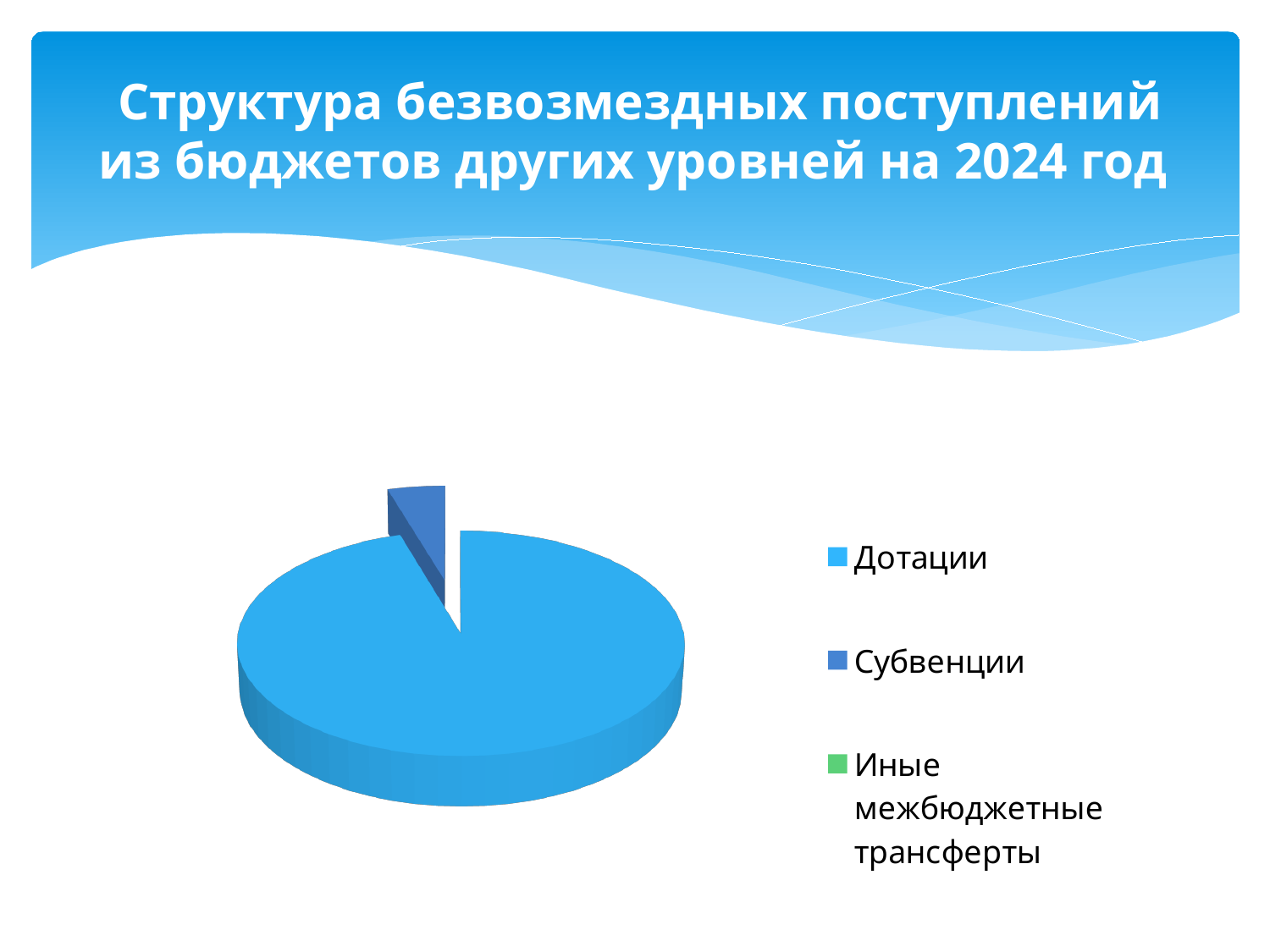
What is the title of the slide? Структура безвозмездных поступлений из бюджетов других уровней на 2024 год Which slice is larger, Дотации or Субвенции? Дотации Does the Дотации slice make up more or less than half of the pie? more How many categories does the legend list? 3 What kind of chart is shown on the slide? pie chart Which legend entry is shown in green? Иные межбюджетные трансферты Which category has the largest slice of the pie? Дотации Which category is represented by the small dark blue slice? Субвенции